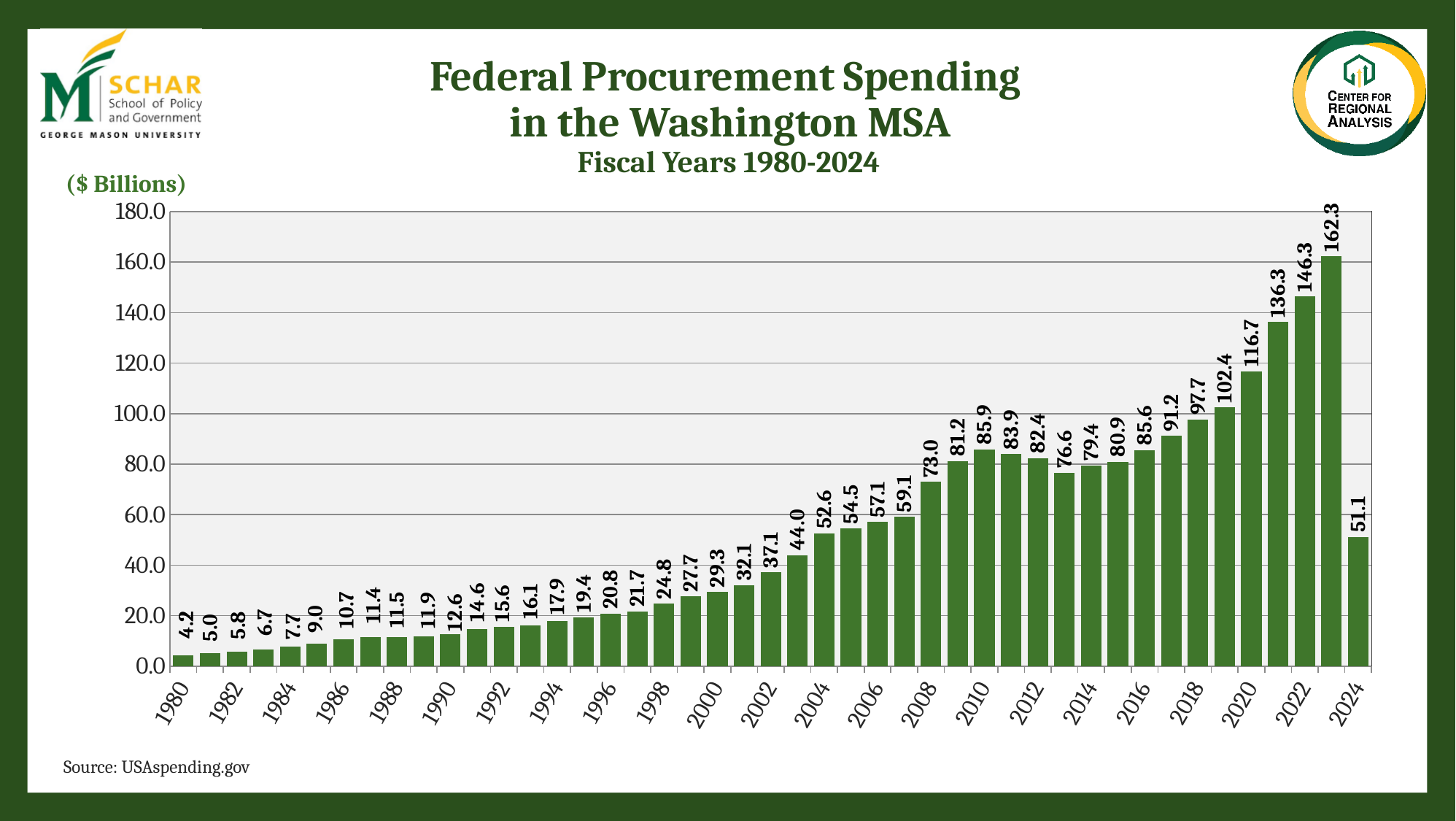
What is the value shown for 2024? 51.1 What kind of chart is shown on the slide? bar chart Which year has the lowest federal procurement spending? 1980 Is the value for 2018 greater or less than 100.0? less How many bars (fiscal years) are plotted on the chart? 45 What is the difference between the values for 2022 and 2020? 29.6 What is the highest value shown on the chart? 162.3 What is the federal procurement spending value shown for 2020? 116.7 What unit is given for the values on the chart? $ Billions What is the value shown for 2008? 73.0 What is the value shown for fiscal year 1980? 4.2 Which is larger, the value for 2010 or the value for 2012? 2010